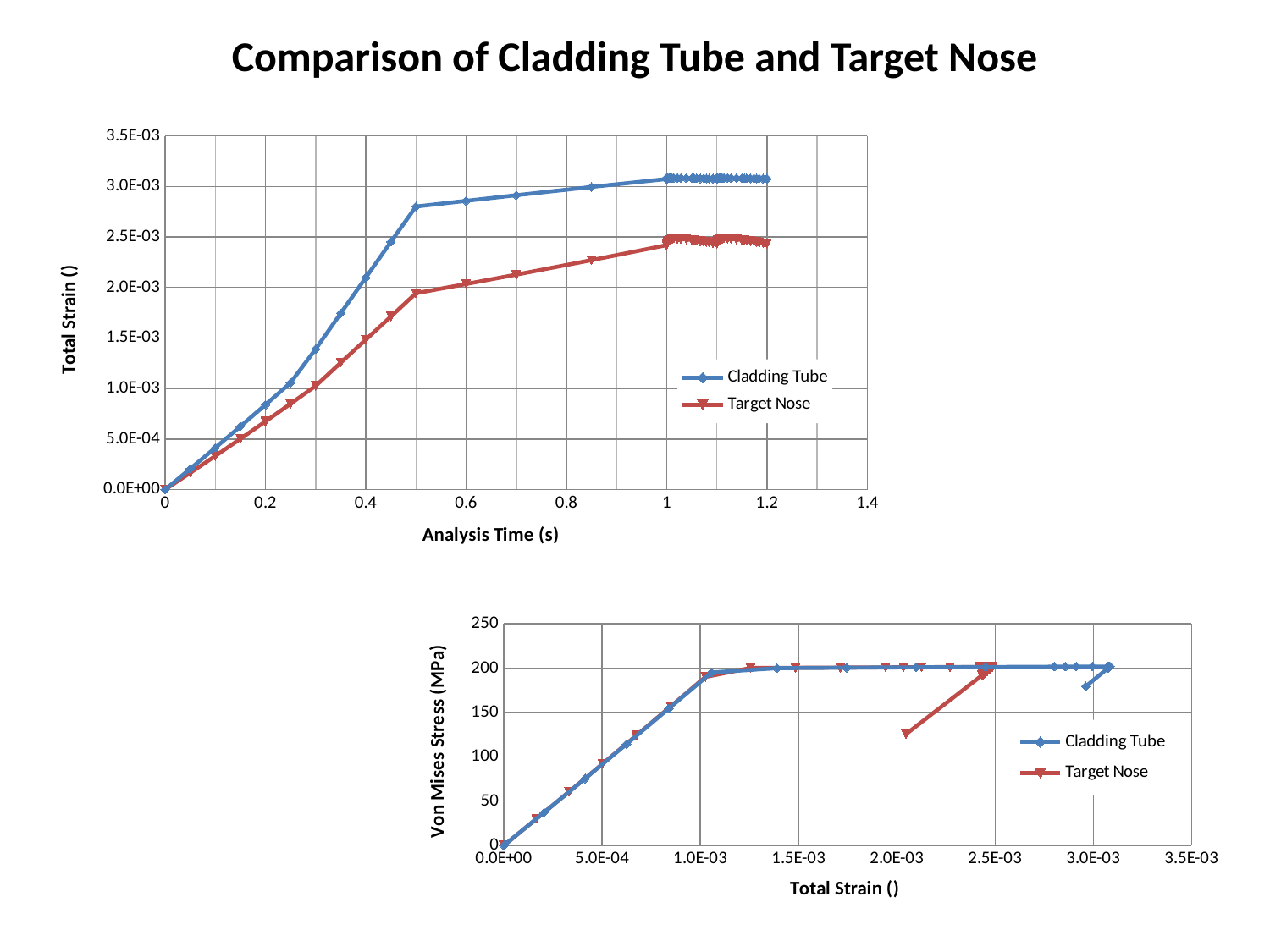
In the top chart, is the Cladding Tube total strain at an analysis time of 0.5 s greater or less than 2.5E-03? greater What are the two series named in the legend of the bottom chart? Cladding Tube and Target Nose In the top chart, is the Target Nose total strain at an analysis time of 0.5 s greater or less than 2.0E-03? less In the top chart, does the Cladding Tube total strain rise or fall as analysis time increases from 0 to 1 s? rise What type of chart is the top chart on the slide? line chart What is the x-axis label of the top chart? Analysis Time (s) In the top chart, which series has the higher total strain at an analysis time of 0.5 s? Cladding Tube In the bottom chart, is the Cladding Tube Von Mises stress at a total strain of 1.5E-03 greater or less than 150 MPa? greater How many series does the legend of the top chart list? 2